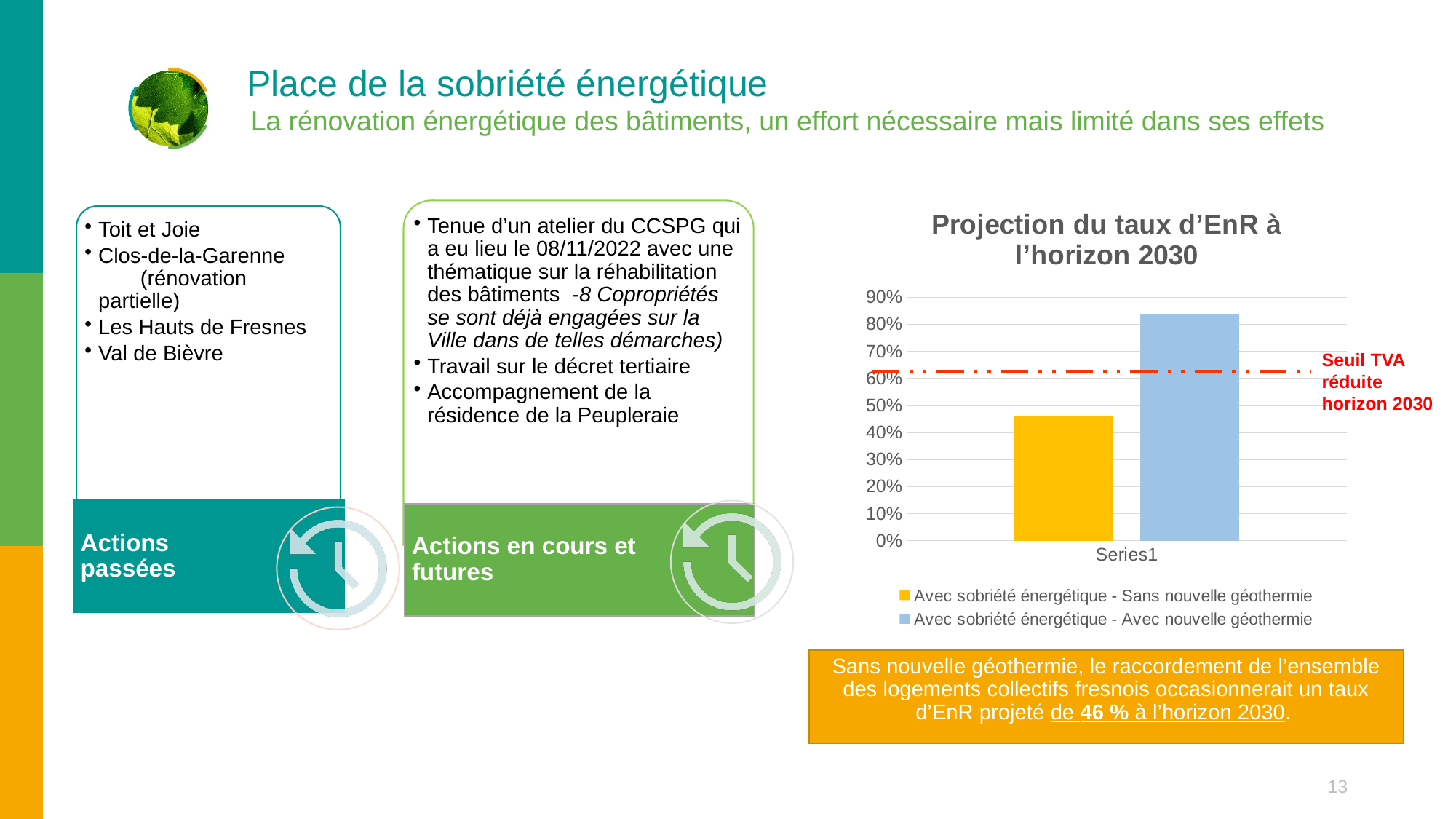
Is the bar for "Avec sobriété énergétique - Avec nouvelle géothermie" larger or smaller than the bar for "Avec sobriété énergétique - Sans nouvelle géothermie"? larger Is the value for "Avec sobriété énergétique - Sans nouvelle géothermie" greater or less than 50%? less How many categories are shown on the x axis of the chart? 1 Is the value for "Avec sobriété énergétique - Sans nouvelle géothermie" greater or less than 40%? greater What kind of chart is shown under the title "Projection du taux d'EnR à l'horizon 2030"? bar chart What is the title of the chart on the slide? Projection du taux d'EnR à l'horizon 2030 How many series does the legend of the "Projection du taux d'EnR à l'horizon 2030" chart list? 2 What does the red dashed horizontal line on the chart represent? Seuil TVA réduite horizon 2030 Which series has the lower value in the "Projection du taux d'EnR à l'horizon 2030" chart? Avec sobriété énergétique - Sans nouvelle géothermie Which series has the higher value in the "Projection du taux d'EnR à l'horizon 2030" chart? Avec sobriété énergétique - Avec nouvelle géothermie Is the value for "Avec sobriété énergétique - Avec nouvelle géothermie" greater or less than 80%? greater According to the slide, what EnR rate is projected for 2030 without new geothermal energy (the "Sans nouvelle géothermie" bar)? 46 %